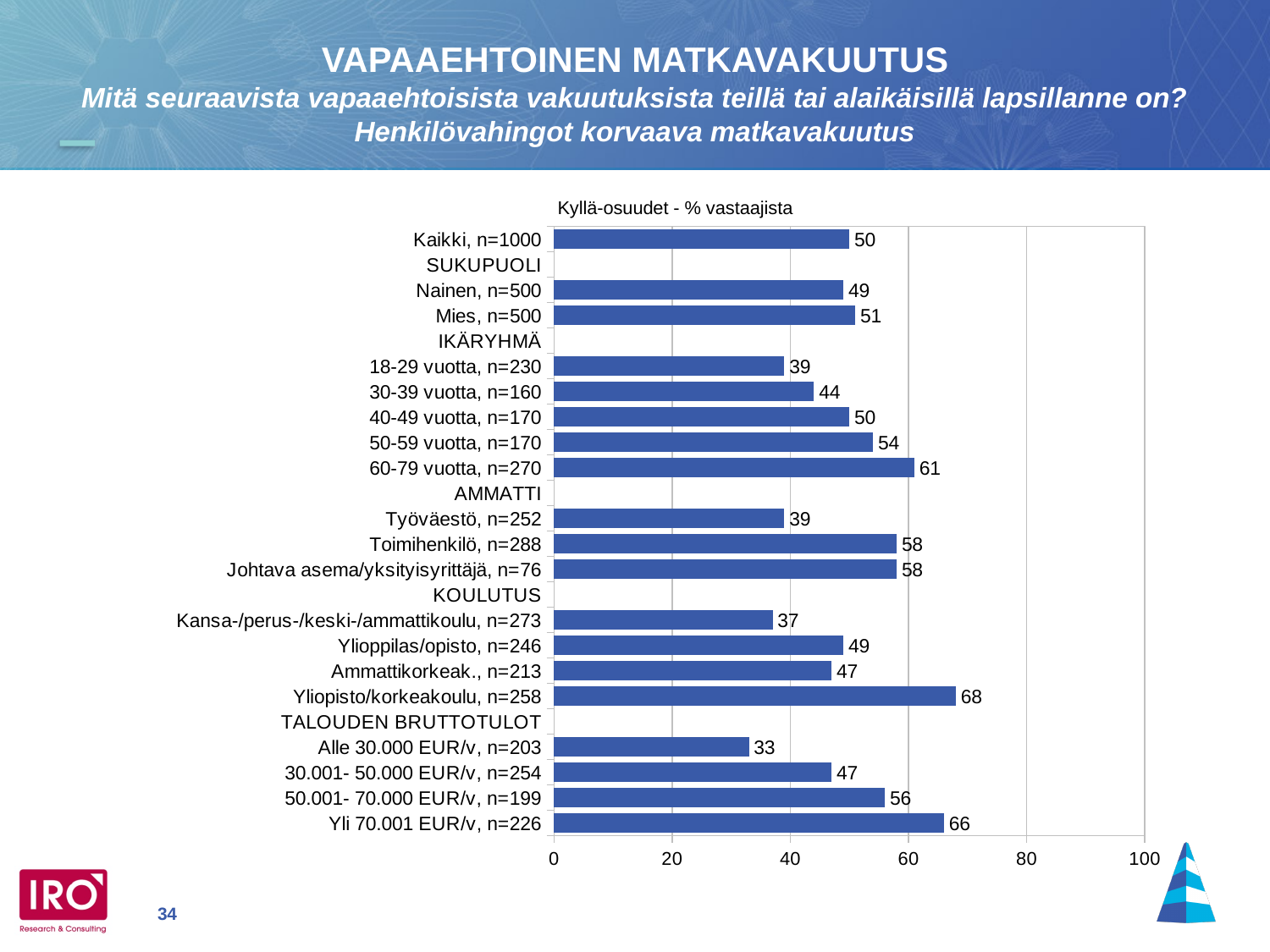
What is the value for 60-79 vuotta, n=270? 61 How many bars are plotted in the chart? 19 Is the value for 18-29 vuotta, n=230 greater or less than 40? less What is the value for Kaikki, n=1000? 50 What is the value for Alle 30.000 EUR/v, n=203? 33 Which category has the lowest value? Alle 30.000 EUR/v, n=203 What kind of chart is shown on the slide? Bar chart What is the difference between the values for Yli 70.001 EUR/v, n=226 and Alle 30.000 EUR/v, n=203? 33 What is the value for Yliopisto/korkeakoulu, n=258? 68 Which category has the highest value? Yliopisto/korkeakoulu, n=258 Which is larger, the value for Työväestö, n=252 or Toimihenkilö, n=288? Toimihenkilö, n=288 What is the title shown above the chart? Kyllä-osuudet - % vastaajista